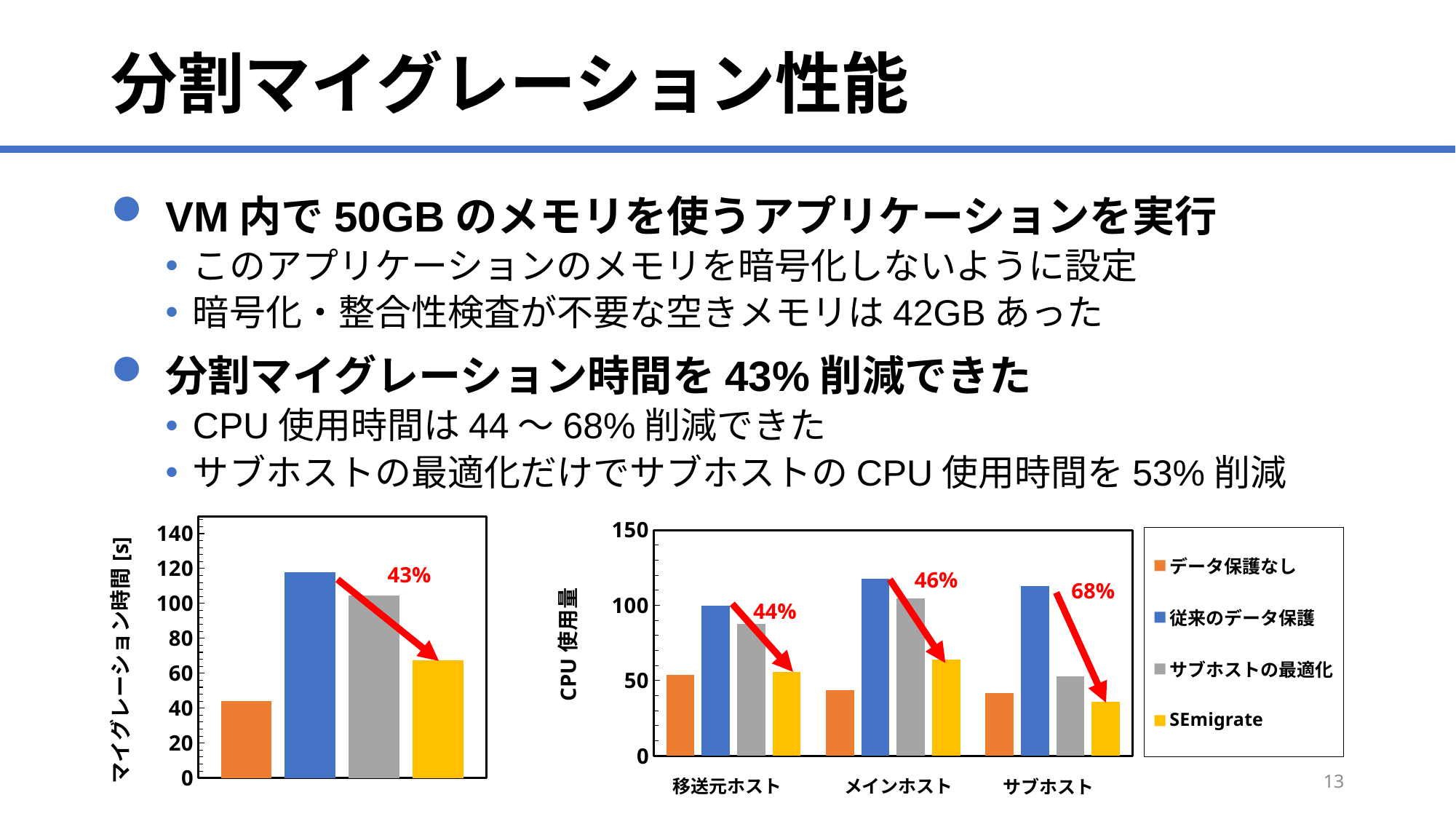
How many series does the legend on the right list? 4 In the right chart (CPU 使用量), what reduction percentage is annotated above the サブホスト group? 68% In the right chart (CPU 使用量), how many host categories are shown on the x axis? 3 What is the y-axis title of the left chart? マイグレーション時間 [s] In the left chart (マイグレーション時間 [s]), which series has the tallest bar? 従来のデータ保護 In the right chart (CPU 使用量), is the value for サブホストの最適化 at サブホスト greater or less than 100? less In the left chart (マイグレーション時間 [s]), is the value for 従来のデータ保護 greater or less than 100? greater In the right chart (CPU 使用量), at サブホスト, which series has the tallest bar? 従来のデータ保護 In the left chart (マイグレーション時間 [s]), is the value for SEmigrate greater or less than 80? less In the left chart (マイグレーション時間 [s]), which series has the shortest bar? データ保護なし What kind of chart is the left chart (マイグレーション時間 [s])? bar chart